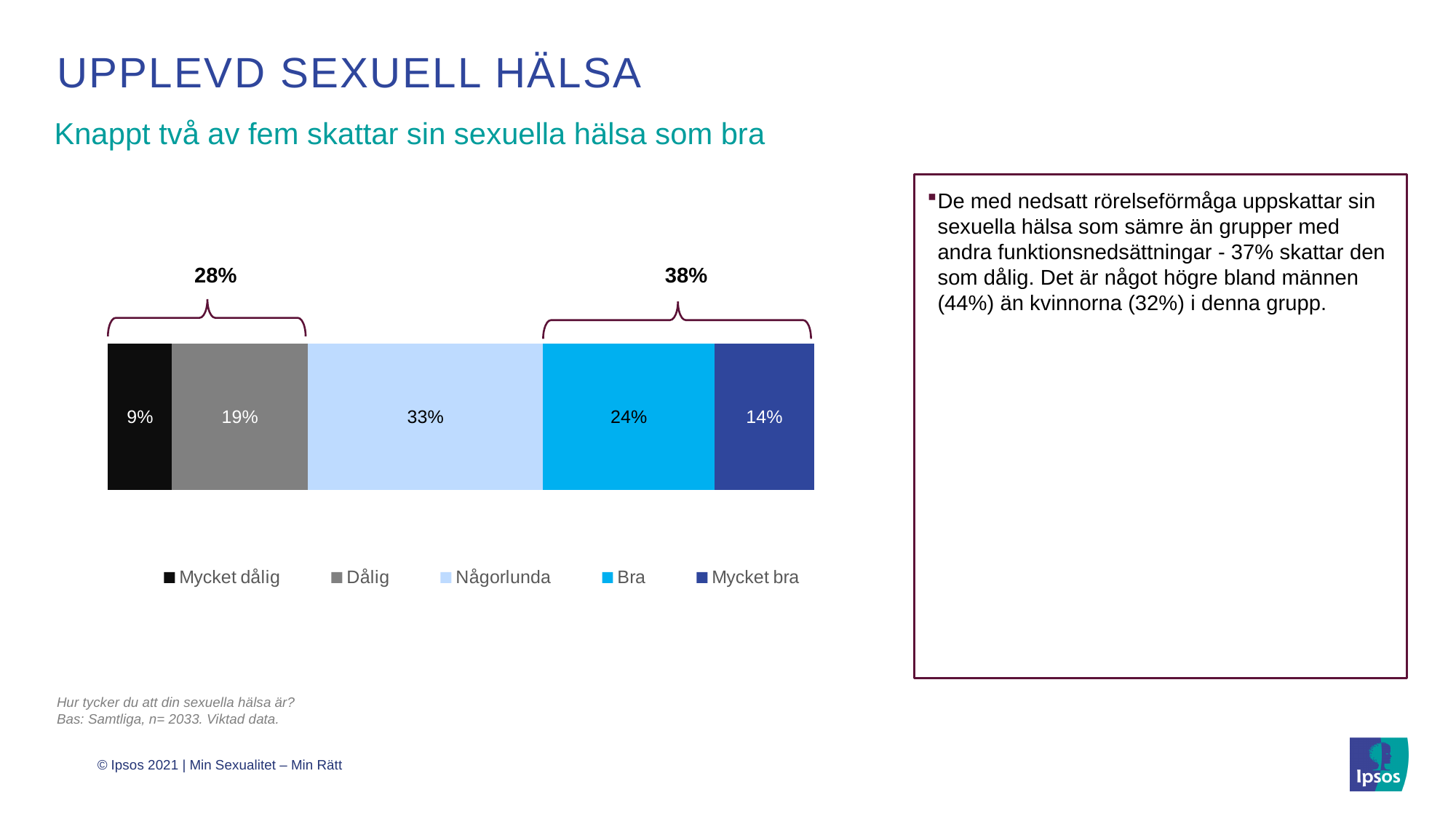
Which is larger, the share for "Dålig" or the share for "Mycket bra"? Dålig What kind of chart is shown on the slide? Stacked bar chart What combined percentage is shown above the bracket grouping "Bra" and "Mycket bra"? 38% What is the difference between the "Bra" share and the "Mycket bra" share? 10% What percentage of respondents rated their sexual health as "Mycket dålig"? 9% What percentage of respondents rated their sexual health as "Dålig"? 19% What percentage of respondents rated their sexual health as "Bra"? 24% What percentage of respondents rated their sexual health as "Mycket bra"? 14% What percentage of respondents rated their sexual health as "Någorlunda"? 33% How many response categories does the legend list? 5 Which response category has the smallest share in the bar? Mycket dålig Which response category has the largest share in the bar? Någorlunda